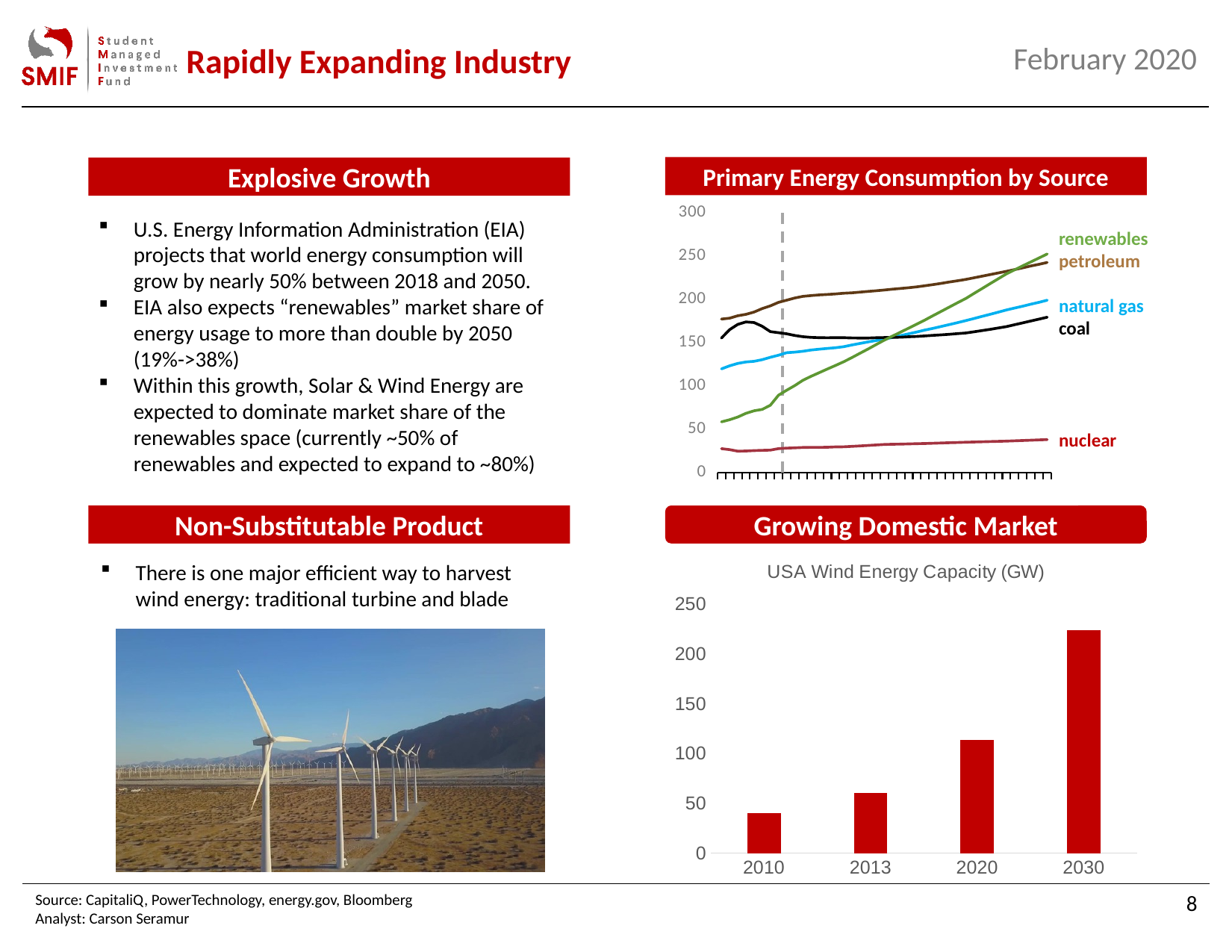
What kind of chart is the 'USA Wind Energy Capacity (GW)' chart under 'Growing Domestic Market'? bar chart In the 'Primary Energy Consumption by Source' chart, which source has the lowest line throughout? nuclear In the 'Primary Energy Consumption by Source' chart, does the renewables line rise or fall along the x axis? rise In the 'USA Wind Energy Capacity (GW)' chart, is the value for 2010 greater or less than 50? less What kind of chart is the 'Primary Energy Consumption by Source' chart? line chart In the 'USA Wind Energy Capacity (GW)' chart, how many years are shown on the x axis? 4 In the 'USA Wind Energy Capacity (GW)' chart, which year has the lowest capacity? 2010 In the 'USA Wind Energy Capacity (GW)' chart, do the values rise or fall from 2010 to 2030? rise In the 'USA Wind Energy Capacity (GW)' chart, which year has the highest capacity? 2030 In the 'USA Wind Energy Capacity (GW)' chart, is the value for 2030 greater or less than 200? greater How many energy sources are labelled in the 'Primary Energy Consumption by Source' chart? 5 In the 'USA Wind Energy Capacity (GW)' chart, is the value for 2020 greater or less than 100? greater